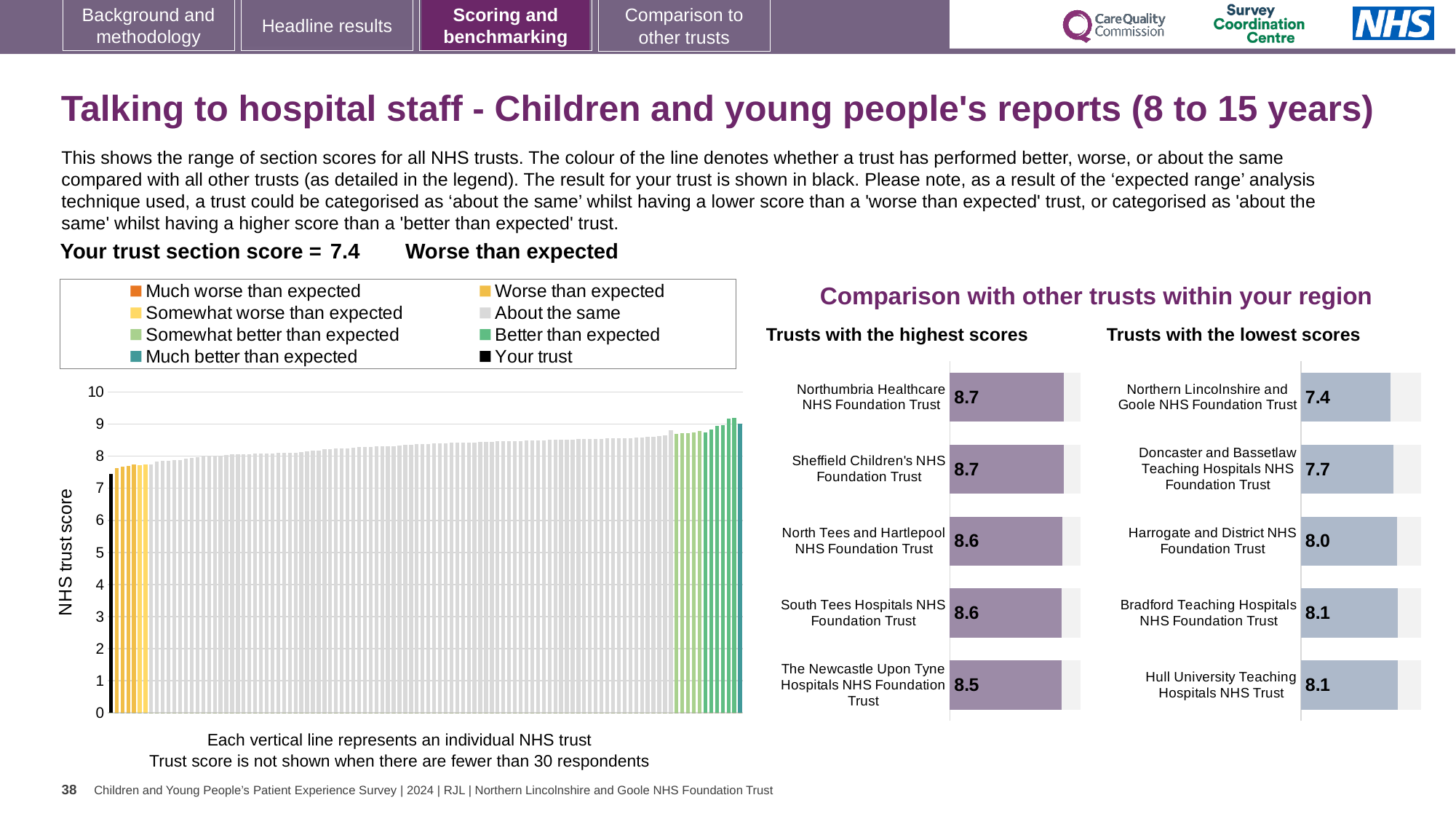
In the 'Trusts with the lowest scores' chart, what is the difference between the scores of Bradford Teaching Hospitals NHS Foundation Trust and Northern Lincolnshire and Goole NHS Foundation Trust? 0.7 What is the y-axis label of the large chart on the left? NHS trust score What kind of chart is the large chart on the left showing all NHS trusts? Bar chart How many trusts are shown in the 'Trusts with the highest scores' chart? 5 In the 'Trusts with the lowest scores' chart, which trust has the lowest score? Northern Lincolnshire and Goole NHS Foundation Trust How many entries does the legend above the large chart on the left list? 8 What is your trust's section score shown on the slide? 7.4 In the 'Trusts with the highest scores' chart, what is the score for Northumbria Healthcare NHS Foundation Trust? 8.7 In the 'Trusts with the lowest scores' chart, what is the score for Harrogate and District NHS Foundation Trust? 8.0 In the large chart on the left, do the trust scores rise or fall from left to right? Rise In the 'Trusts with the highest scores' chart, which has the higher score: North Tees and Hartlepool NHS Foundation Trust or The Newcastle Upon Tyne Hospitals NHS Foundation Trust? North Tees and Hartlepool NHS Foundation Trust In the 'Trusts with the highest scores' chart, what is the difference between the scores of Northumbria Healthcare NHS Foundation Trust and The Newcastle Upon Tyne Hospitals NHS Foundation Trust? 0.2